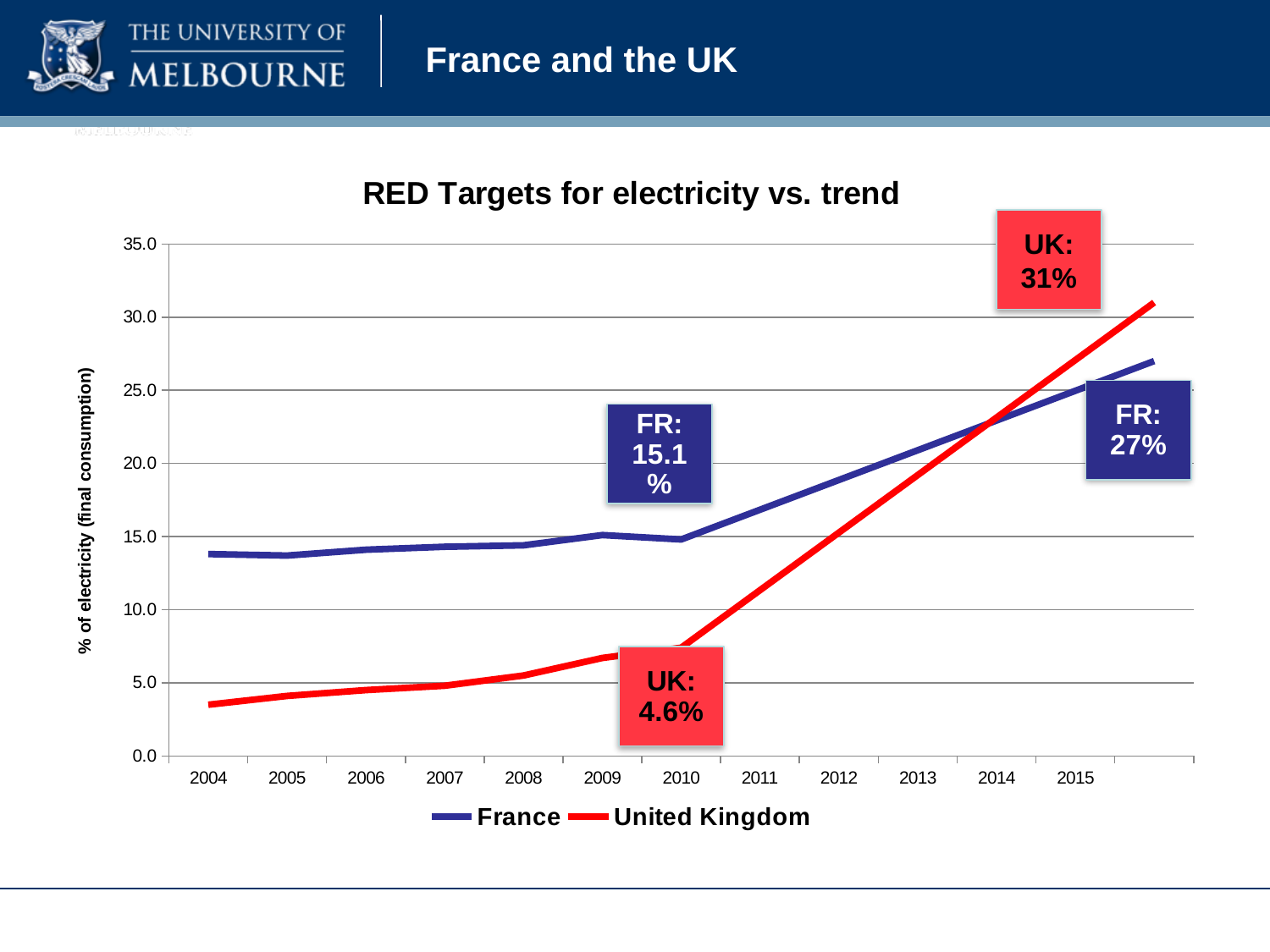
What is the title of the chart? RED Targets for electricity vs. trend What value is shown in the FR label at the right edge of the chart? 27% Is the value for France in 2004 greater or less than 10.0? greater What value is shown in the FR label near 2010? 15.1% What is the label on the vertical axis? % of electricity (final consumption) What type of chart is shown on the slide? line chart What value is shown in the UK label at the upper right of the chart? 31% Is the value for the United Kingdom in 2004 greater or less than 5.0? less How many series does the legend list? 2 What is the difference between the UK's 31% label and France's 27% label? 4% What value is shown in the UK label near 2010? 4.6% Which series has the higher value in 2004, France or United Kingdom? France